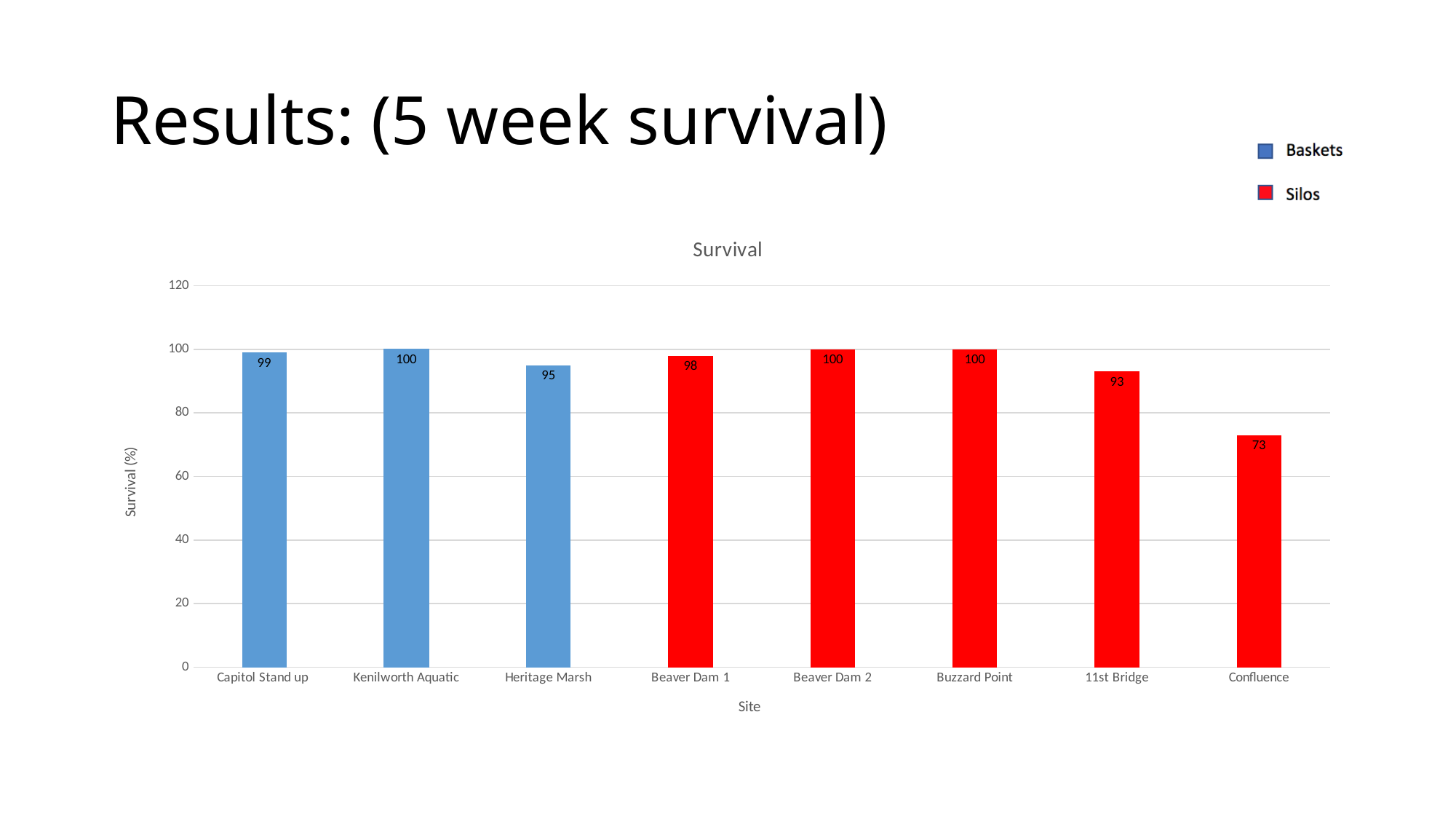
How many sites are shown on the x axis? 8 What is the survival value for Capitol Stand up? 99 Which site has the lowest survival value? Confluence What kind of chart is shown on the slide? bar chart What is the survival value for Confluence? 73 What is the survival value for 11st Bridge? 93 What colour are the Silos bars? red Is the value for Confluence greater or less than 80? less What is the difference between the survival values for Beaver Dam 1 and Confluence? 25 How many series does the legend list? 2 What is the survival value for Heritage Marsh? 95 Which has a higher survival value, Heritage Marsh or 11st Bridge? Heritage Marsh